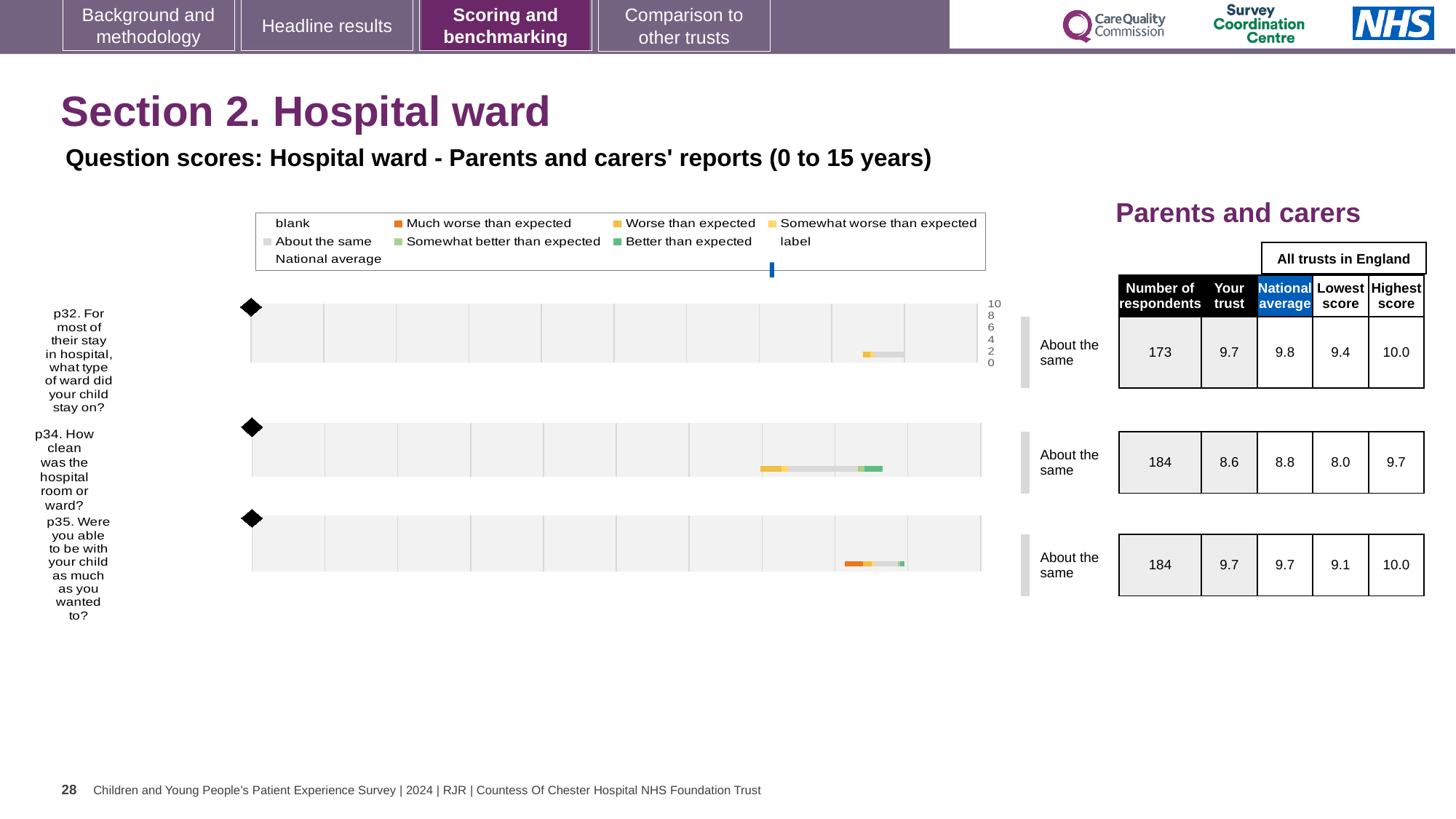
Which question has the lowest 'Your trust' score? p34 What kind of chart is used for each question on the slide? bar chart What is the 'Your trust' score for p34 (How clean was the hospital room or ward?)? 8.6 How many question charts are shown on the slide? 3 For p34, what is the difference between the highest score and the lowest score across all trusts in England? 1.7 What is the highest score across all trusts in England for p32? 10.0 How many entries does the legend above the charts list? 9 What is the national average score for p32 (what type of ward did your child stay on?)? 9.8 For p34, which is larger: the 'Your trust' score or the national average? National average How many respondents answered p32? 173 What is the lowest score across all trusts in England for p35? 9.1 What benchmark category is shown for p35 (Were you able to be with your child as much as you wanted to?)? About the same